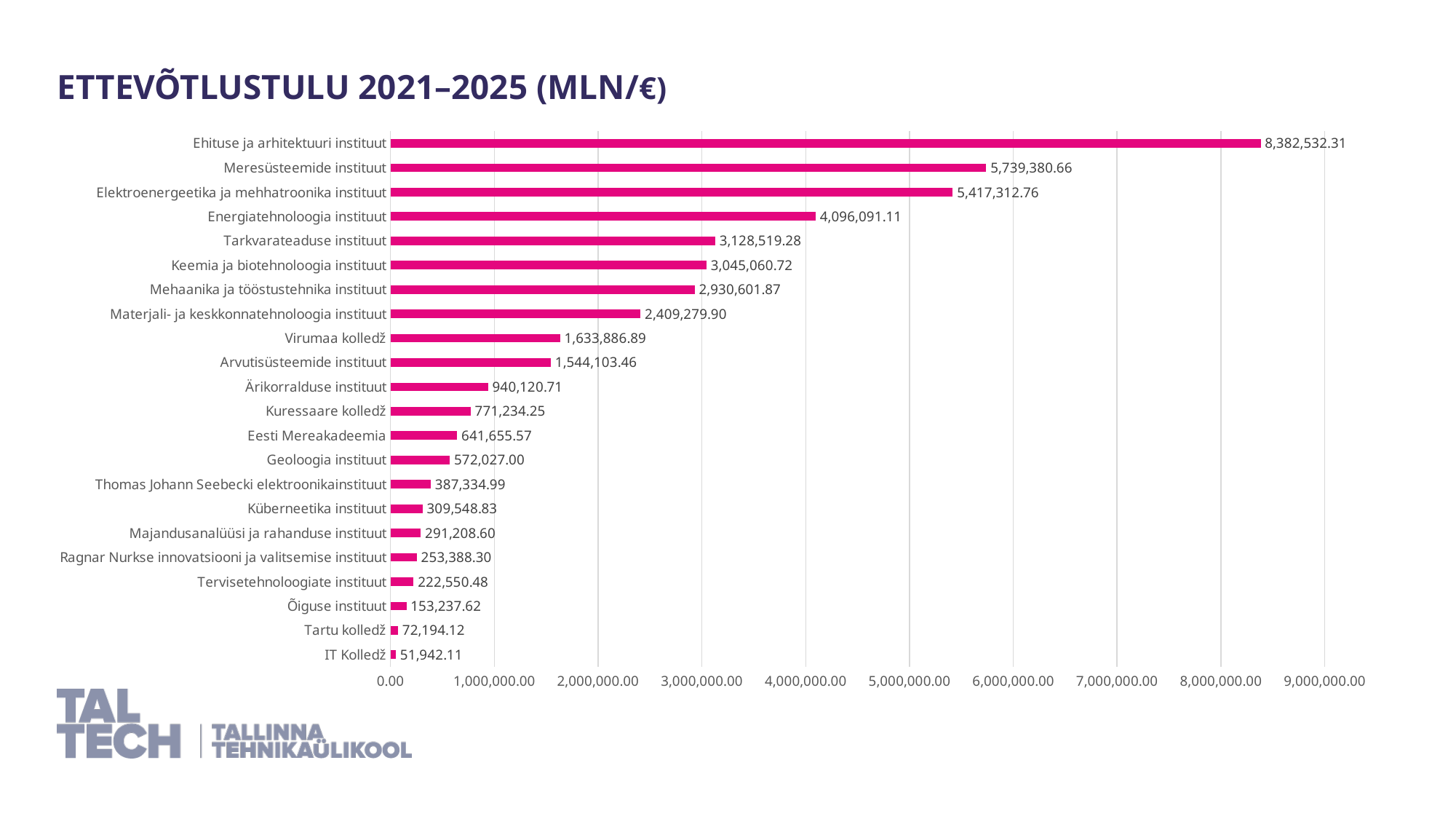
What is the difference between the values for Ehituse ja arhitektuuri instituut and Meresüsteemide instituut? 2,643,151.65 What is the title of the chart? ETTEVÕTLUSTULU 2021–2025 (MLN/€) What is the value for Meresüsteemide instituut? 5,739,380.66 What is the difference between the values for Tartu kolledž and IT Kolledž? 20,252.01 How many categories are shown in the chart? 22 Which category has the highest value? Ehituse ja arhitektuuri instituut Which is larger, the value for Energiatehnoloogia instituut or the value for Tarkvarateaduse instituut? Energiatehnoloogia instituut Which category has the lowest value? IT Kolledž What is the value for Virumaa kolledž? 1,633,886.89 What is the value for Geoloogia instituut? 572,027.00 What is the value for Õiguse instituut? 153,237.62 What kind of chart is shown on the slide? Bar chart